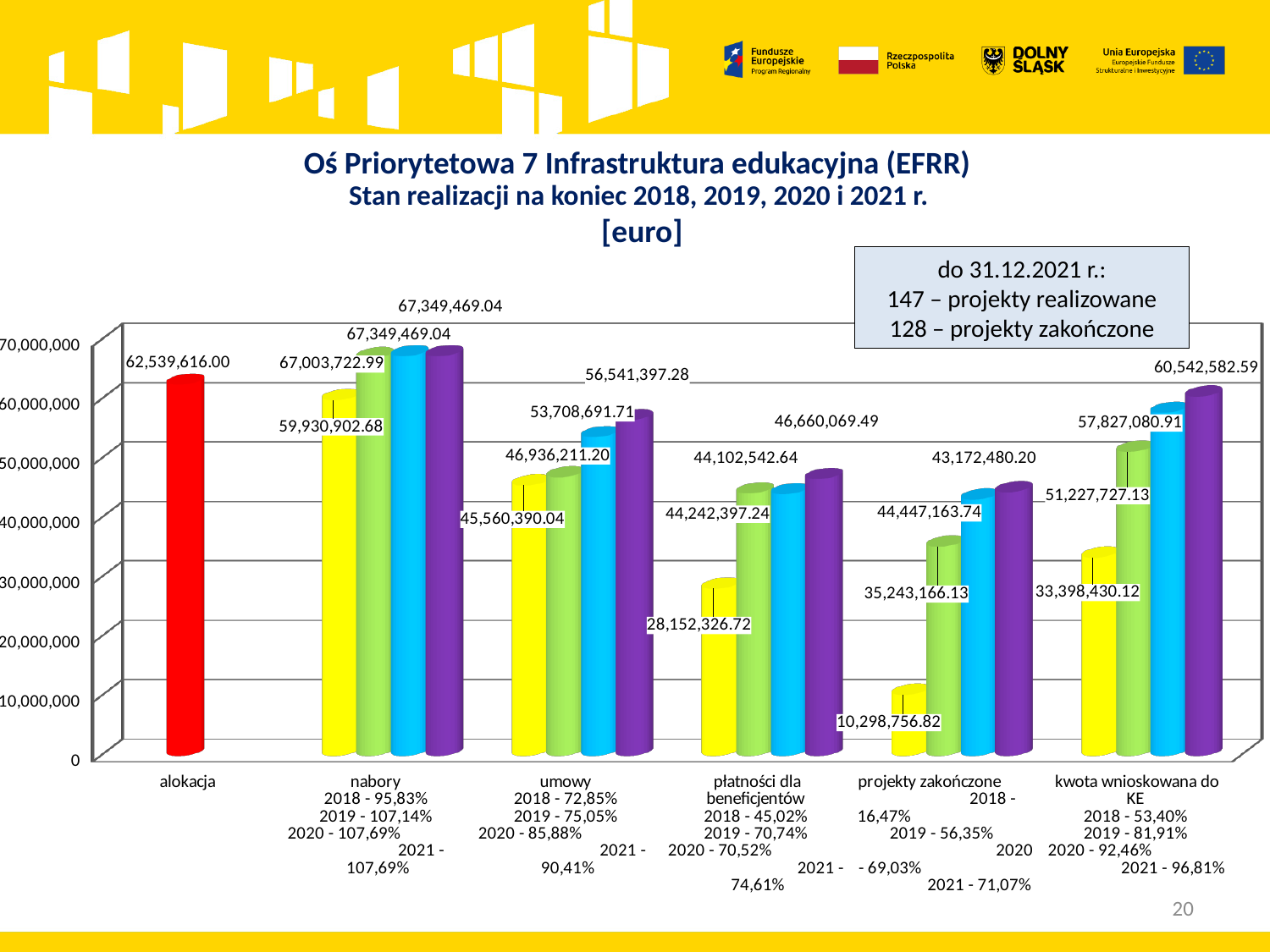
What is the value of the red alokacja bar? 62,539,616.00 How many categories are shown along the x axis of the chart? 6 What is the value of the last (purple, 2021) bar in the kwota wnioskowana do KE category? 60,542,582.59 What is the value of the last (purple, 2021) bar in the umowy category? 56,541,397.28 What kind of chart is shown on the slide? bar chart What is the difference between the alokacja value (62,539,616.00) and the 2018 nabory value (59,930,902.68)? 2,608,713.32 According to the text box on the slide, how many projects were being realised (projekty realizowane) as of 31.12.2021? 147 Is the value of the alokacja bar greater or less than 60,000,000? greater What is the value of the first (yellow, 2018) bar in the nabory category? 59,930,902.68 What is the value of the first (yellow, 2018) bar in the projekty zakończone category? 10,298,756.82 Which category contains the lowest bar on the chart? projekty zakończone